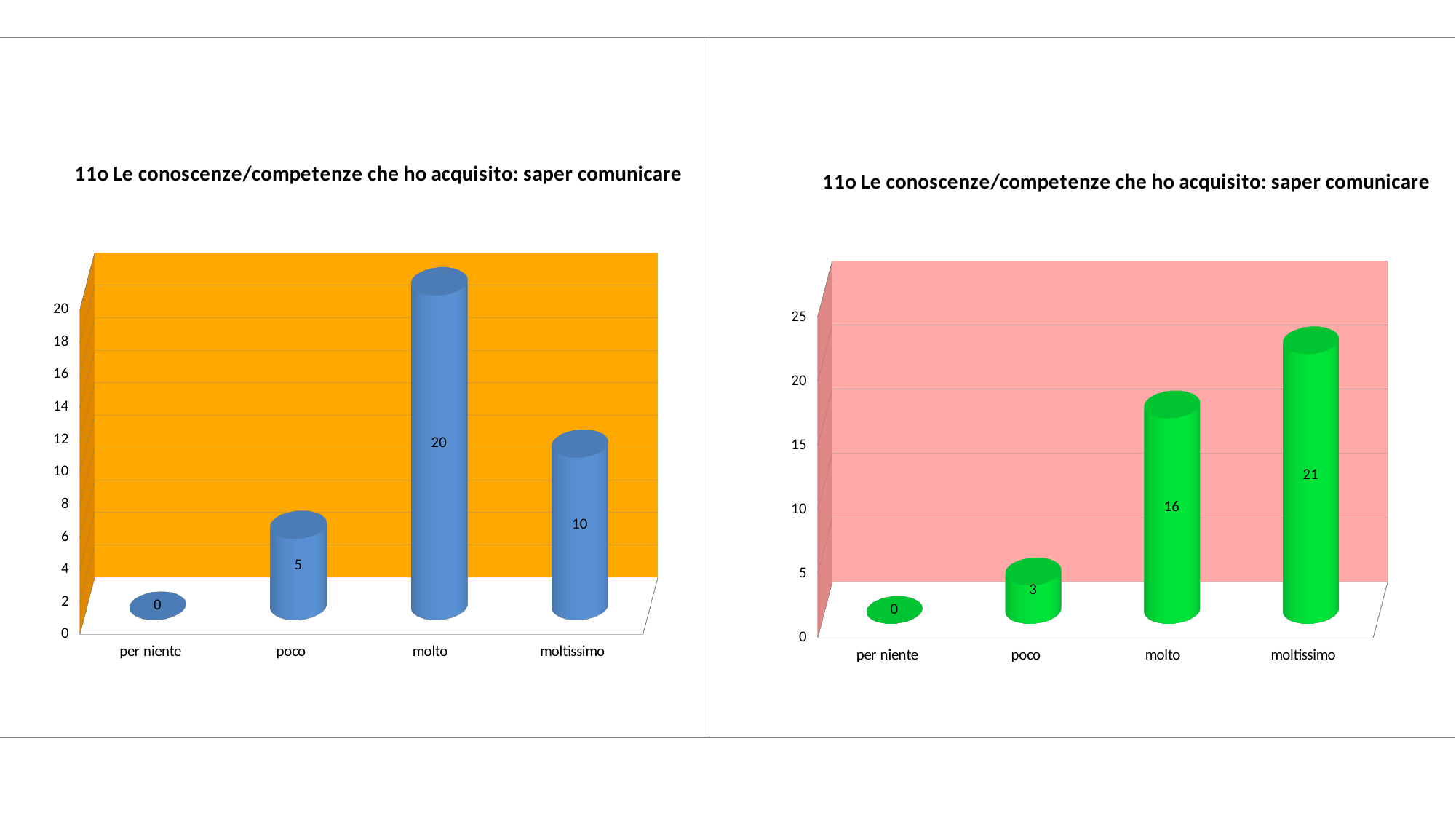
In the right chart, which category has the highest value? moltissimo In the right chart, what is the value for molto? 16 How many categories are shown on the x axis of the right chart? 4 In the right chart, which category has the lowest value? per niente In the right chart, what is the value for moltissimo? 21 In the left chart, which category has the highest value? molto In the left chart, what is the difference between the values for molto and moltissimo? 10 In the left chart, which is larger, the value for poco or the value for moltissimo? moltissimo In the right chart, what is the difference between the values for moltissimo and poco? 18 In the left chart, what is the value for molto? 20 What kind of chart is the left chart? bar chart In the left chart, what is the value for poco? 5